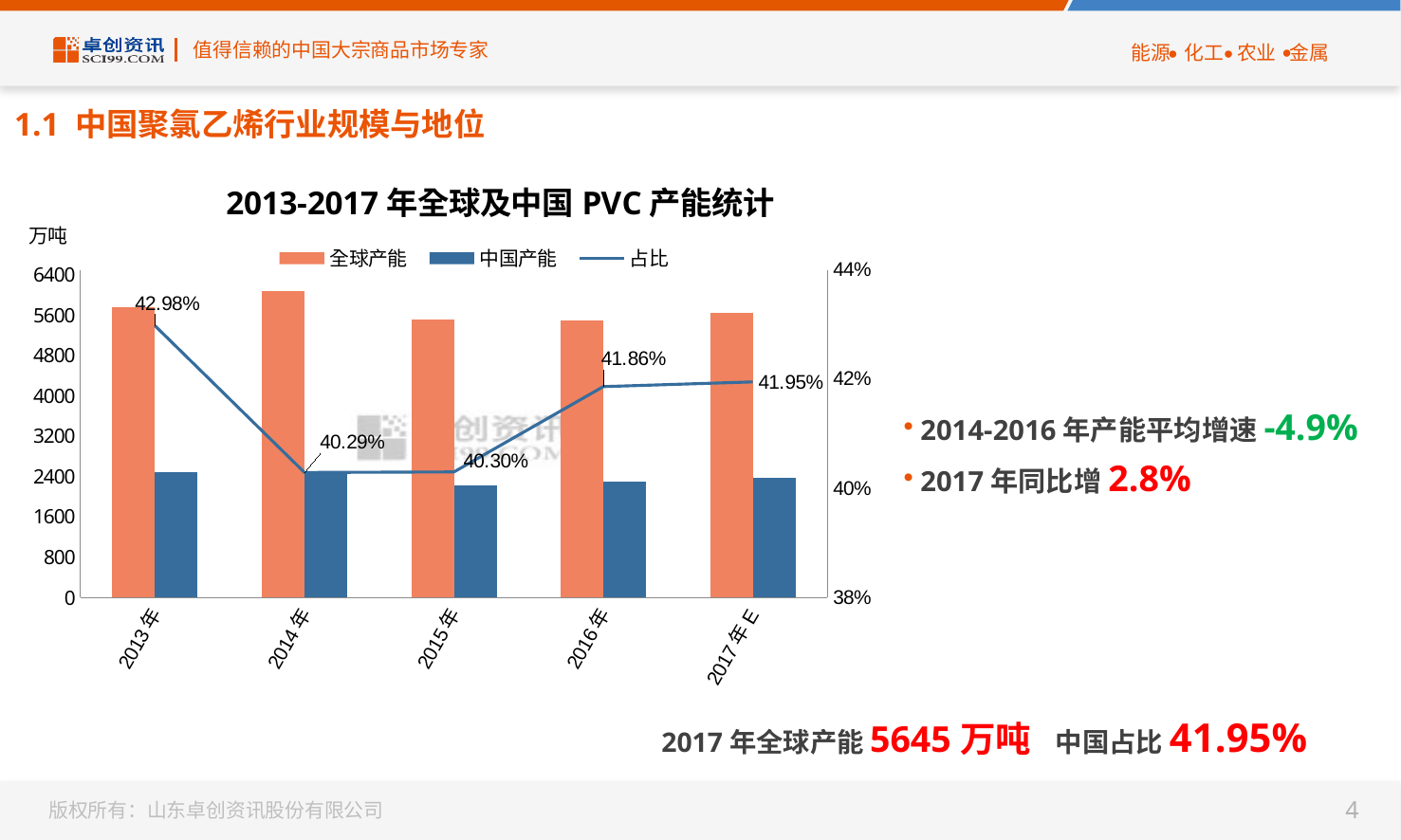
Which year has the larger 占比 value, 2015年 or 2016年? 2016年 What is the difference between the 占比 values for 2013年 and 2014年? 2.69% What is the 占比 value for 2017年E? 41.95% What kind of chart is this? Bar chart with a line Does the 占比 line rise or fall from 2014年 to 2017年E? Rise In which year is the 占比 line at its highest? 2013年 What is the 占比 value for 2013年? 42.98% Is the 中国产能 bar for 2015年 greater or less than 2400? less What is the 占比 value for 2016年? 41.86% How many years are shown on the x axis? 5 Is the 全球产能 bar for 2014年 greater or less than 5600? greater How many series does the legend list? 3